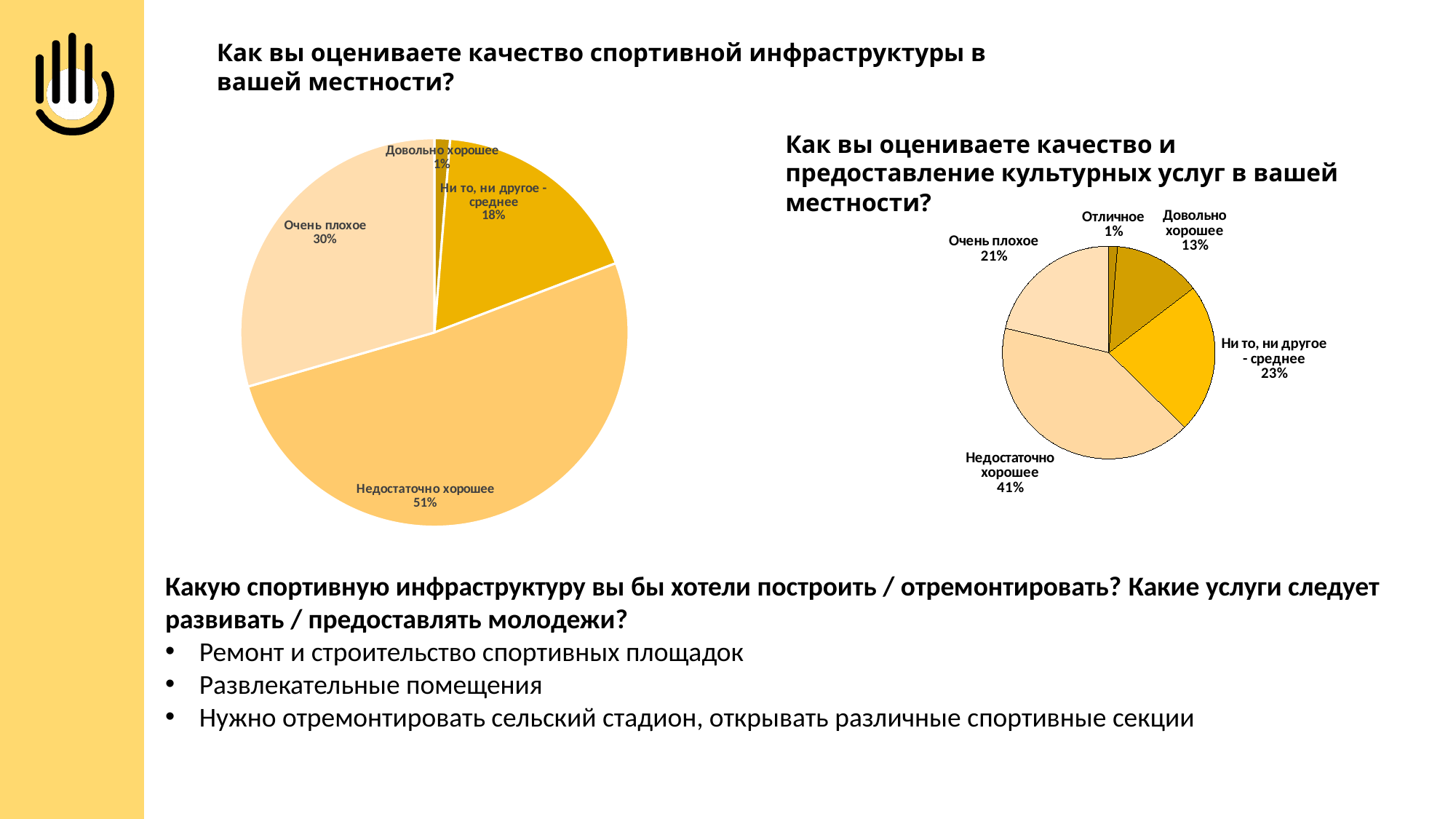
In the right pie chart (cultural services), how many slices are there? 5 In the left pie chart (sports infrastructure), how many slices are there? 4 In the right pie chart (cultural services), what share is labelled "Довольно хорошее"? 13% In the left pie chart (sports infrastructure), what share is labelled "Недостаточно хорошее"? 51% In the right pie chart (cultural services), which category has the largest share? Недостаточно хорошее What kind of chart is used on the left for the question about sports infrastructure quality? Pie chart Which chart has the larger share for "Недостаточно хорошее": the left (sports infrastructure) or the right (cultural services)? Left (sports infrastructure) In the left pie chart (sports infrastructure), what is the difference between the shares for "Очень плохое" and "Ни то, ни другое - среднее"? 12% In the left pie chart (sports infrastructure), which category has the smallest share? Довольно хорошее In the left pie chart (sports infrastructure), what share is labelled "Очень плохое"? 30% In the right pie chart (cultural services), what share is labelled "Ни то, ни другое - среднее"? 23% In the right pie chart (cultural services), which is larger: the share for "Очень плохое" or for "Довольно хорошее"? Очень плохое